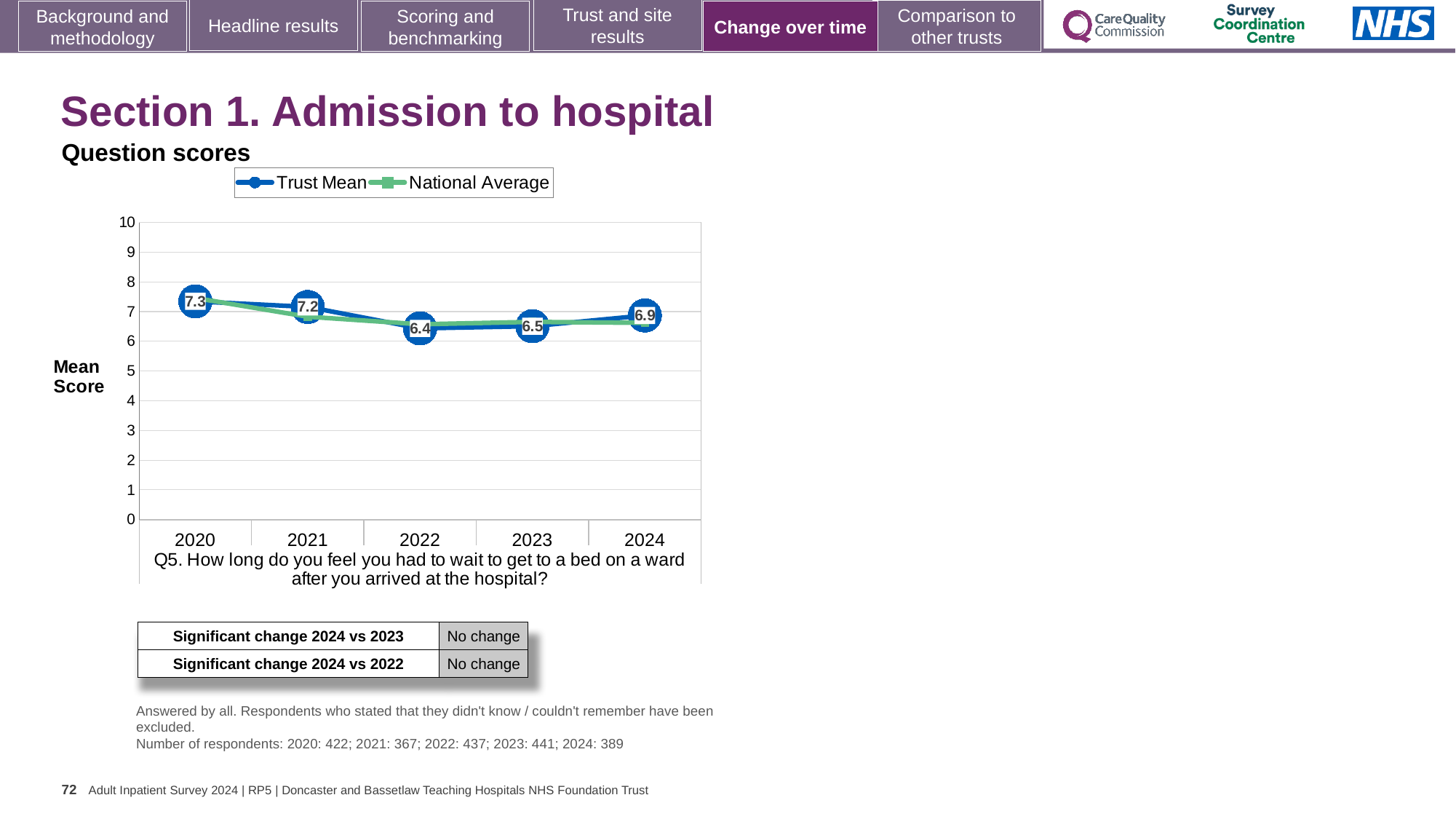
How many years are plotted on the x axis? 5 Does the Trust Mean score rise or fall from 2020 to 2022? Fall What is the difference between the Trust Mean score in 2020 and in 2022? 0.9 What is the Trust Mean score for 2022? 6.4 How many series does the legend list? 2 Is the Trust Mean score for 2023 greater or less than 7? less What is the Trust Mean score for 2024? 6.9 What kind of chart is shown? Line chart Which year has a higher Trust Mean score, 2021 or 2023? 2021 In which year is the Trust Mean score lowest? 2022 What is the Trust Mean score for 2020? 7.3 In which year is the Trust Mean score highest? 2020